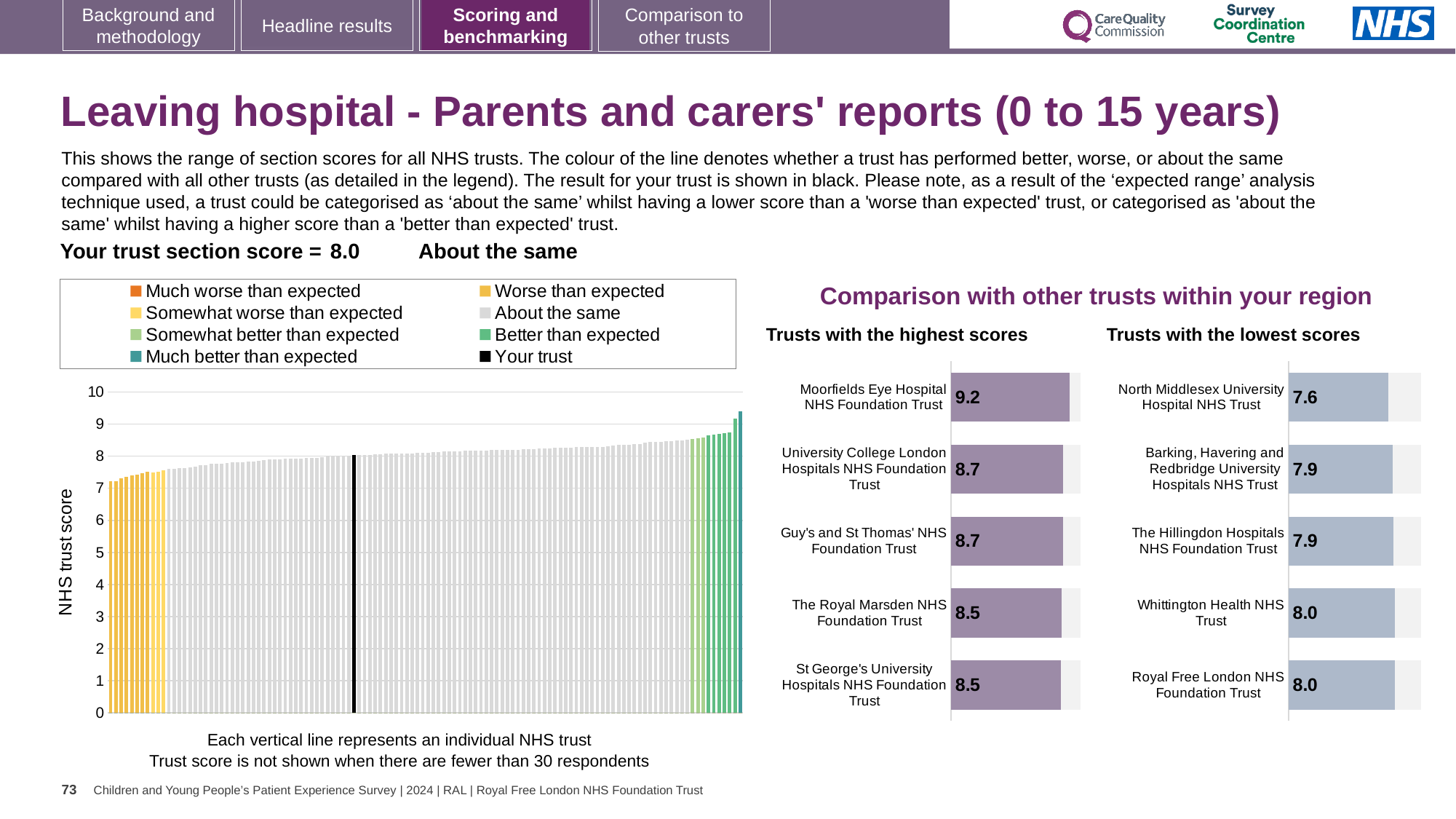
In the main 'NHS trust score' chart, do the trust scores rise or fall from left to right? Rise What kind of chart is the main chart on the left showing the NHS trust score for each trust? Bar chart In the 'Trusts with the highest scores' chart, what is the score for Moorfields Eye Hospital NHS Foundation Trust? 9.2 In the 'Trusts with the highest scores' chart, what is the difference between the scores of Moorfields Eye Hospital NHS Foundation Trust and University College London Hospitals NHS Foundation Trust? 0.5 In the main 'NHS trust score' chart, is the value of the tallest bar greater or less than 9? greater In the 'Trusts with the lowest scores' chart, what is the score for North Middlesex University Hospital NHS Trust? 7.6 In the 'Trusts with the lowest scores' chart, which has the larger score: Whittington Health NHS Trust or North Middlesex University Hospital NHS Trust? Whittington Health NHS Trust In the 'Trusts with the lowest scores' chart, which trust has the lowest score? North Middlesex University Hospital NHS Trust In the 'Trusts with the highest scores' chart, which trust has the highest score? Moorfields Eye Hospital NHS Foundation Trust In the 'Trusts with the lowest scores' chart, what is the difference between the scores of The Hillingdon Hospitals NHS Foundation Trust and North Middlesex University Hospital NHS Trust? 0.3 How many trusts are shown in the 'Trusts with the highest scores' chart? 5 How many entries does the legend of the main 'NHS trust score' chart list? 8